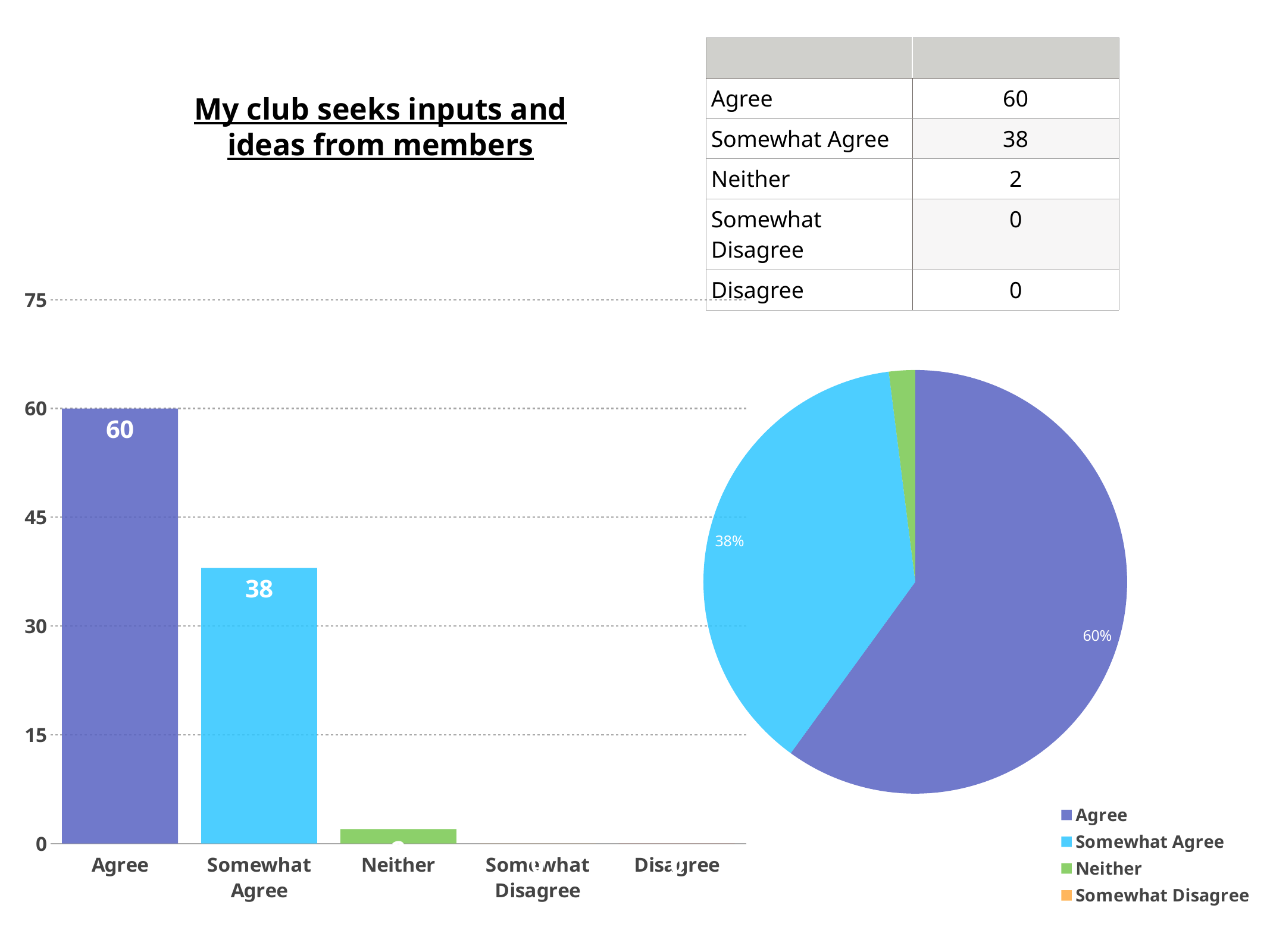
What is the title shown above the bar chart? My club seeks inputs and ideas from members How many categories are shown on the x axis of the bar chart? 5 On the bar chart, what is the value for Agree? 60 On the pie chart, what share of the pie does the Agree slice represent? 60% On the bar chart, which category has the highest value? Agree On the bar chart, what is the value for Somewhat Agree? 38 On the bar chart, is the value for Somewhat Agree greater or less than 45? less What kind of chart is the chart on the left of the slide? bar chart On the bar chart, which is larger, the value for Somewhat Agree or the value for Neither? Somewhat Agree How many entries does the legend of the pie chart list? 4 On the pie chart, what share of the pie does the Somewhat Agree slice represent? 38% On the bar chart, what is the difference between the values for Agree and Somewhat Agree? 22